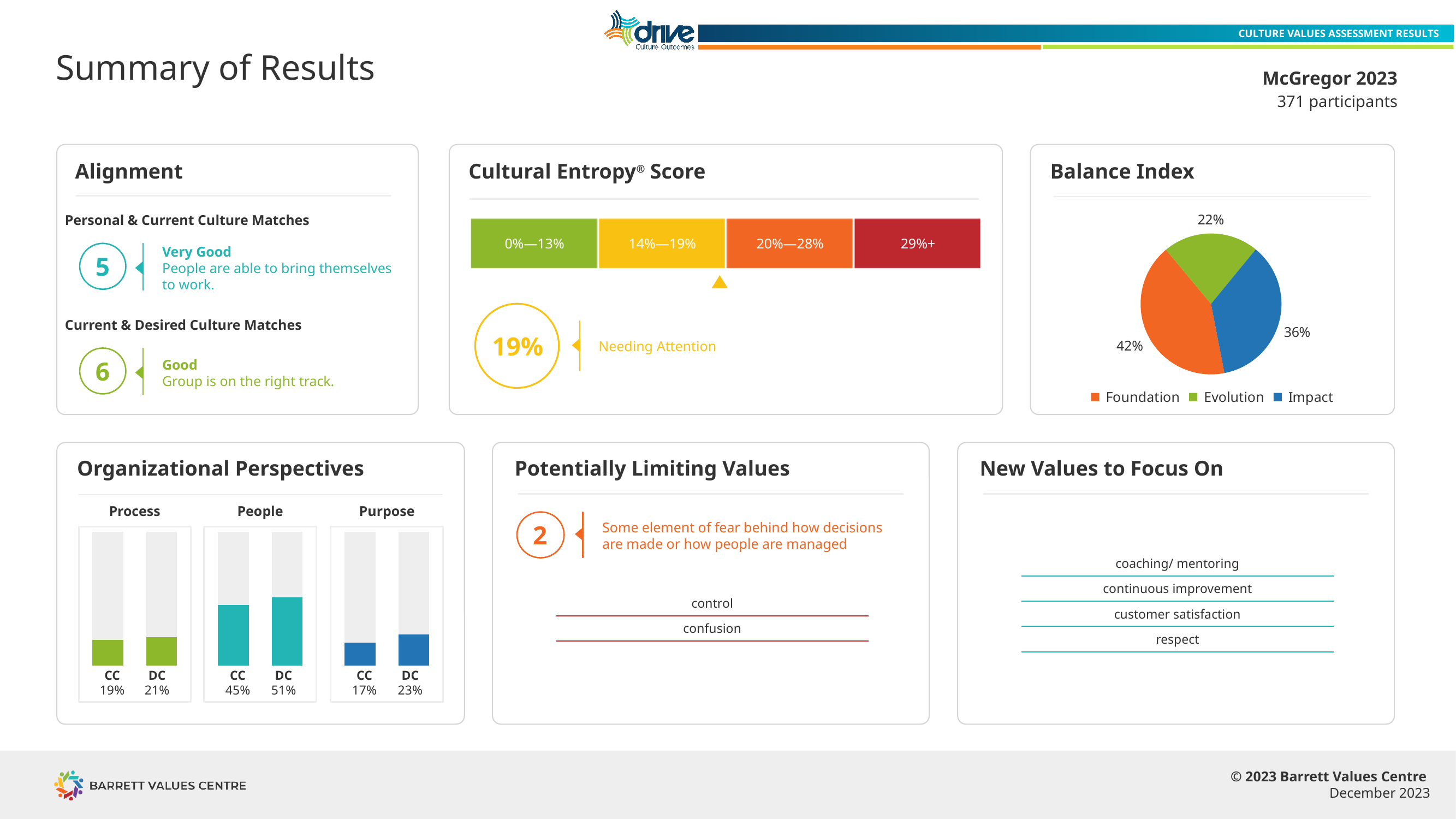
What type of chart is used for the Balance Index? Pie chart How many categories does the Balance Index pie chart legend list? 3 In the Balance Index pie chart, what share does Impact have? 36% In the Organizational Perspectives chart, which is larger for People: CC or DC? DC In the Balance Index pie chart, what is the difference between the Foundation and Impact shares? 6% In the Organizational Perspectives chart, what is the difference between the DC and CC values for Process? 2% In the Balance Index pie chart, what share does Foundation have? 42% In the Organizational Perspectives chart, what is the CC value for Purpose? 17% In the Balance Index pie chart, what share does Evolution have? 22% In the Balance Index pie chart, which category has the smallest slice? Evolution In the Balance Index pie chart, which category has the largest slice? Foundation In the Organizational Perspectives chart, what is the DC value for People? 51%